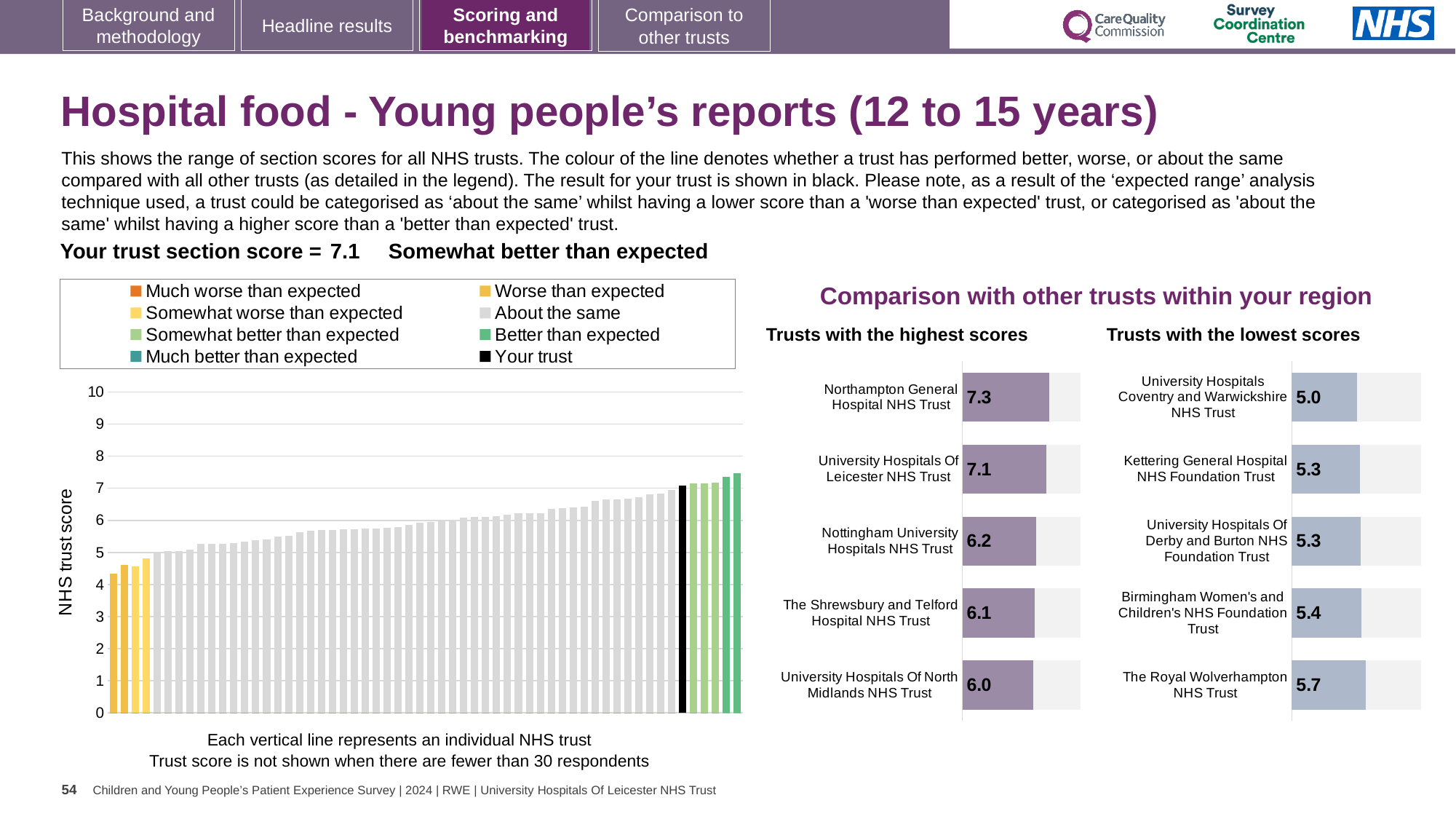
In the main NHS trust score chart on the left, do the bar values rise or fall from left to right? rise In the 'Trusts with the lowest scores' chart, which has the larger score: Birmingham Women's and Children's NHS Foundation Trust or The Royal Wolverhampton NHS Trust? The Royal Wolverhampton NHS Trust How many entries does the legend above the main NHS trust score chart list? 8 How many trusts are listed in the 'Trusts with the highest scores' chart? 5 In the 'Trusts with the lowest scores' chart, what is the score for The Royal Wolverhampton NHS Trust? 5.7 In the 'Trusts with the highest scores' chart, which trust has the highest score? Northampton General Hospital NHS Trust In the main NHS trust score chart on the left, what is the score for your trust (the black bar)? 7.1 What kind of chart is the main NHS trust score chart on the left? bar chart In the main NHS trust score chart on the left, is the value of the lowest bar greater or less than 5? less In the 'Trusts with the highest scores' chart, what is the score for Northampton General Hospital NHS Trust? 7.3 In the 'Trusts with the lowest scores' chart, which trust has the lowest score? University Hospitals Coventry and Warwickshire NHS Trust In the 'Trusts with the highest scores' chart, what is the difference between the scores of Northampton General Hospital NHS Trust and University Hospitals Of North Midlands NHS Trust? 1.3